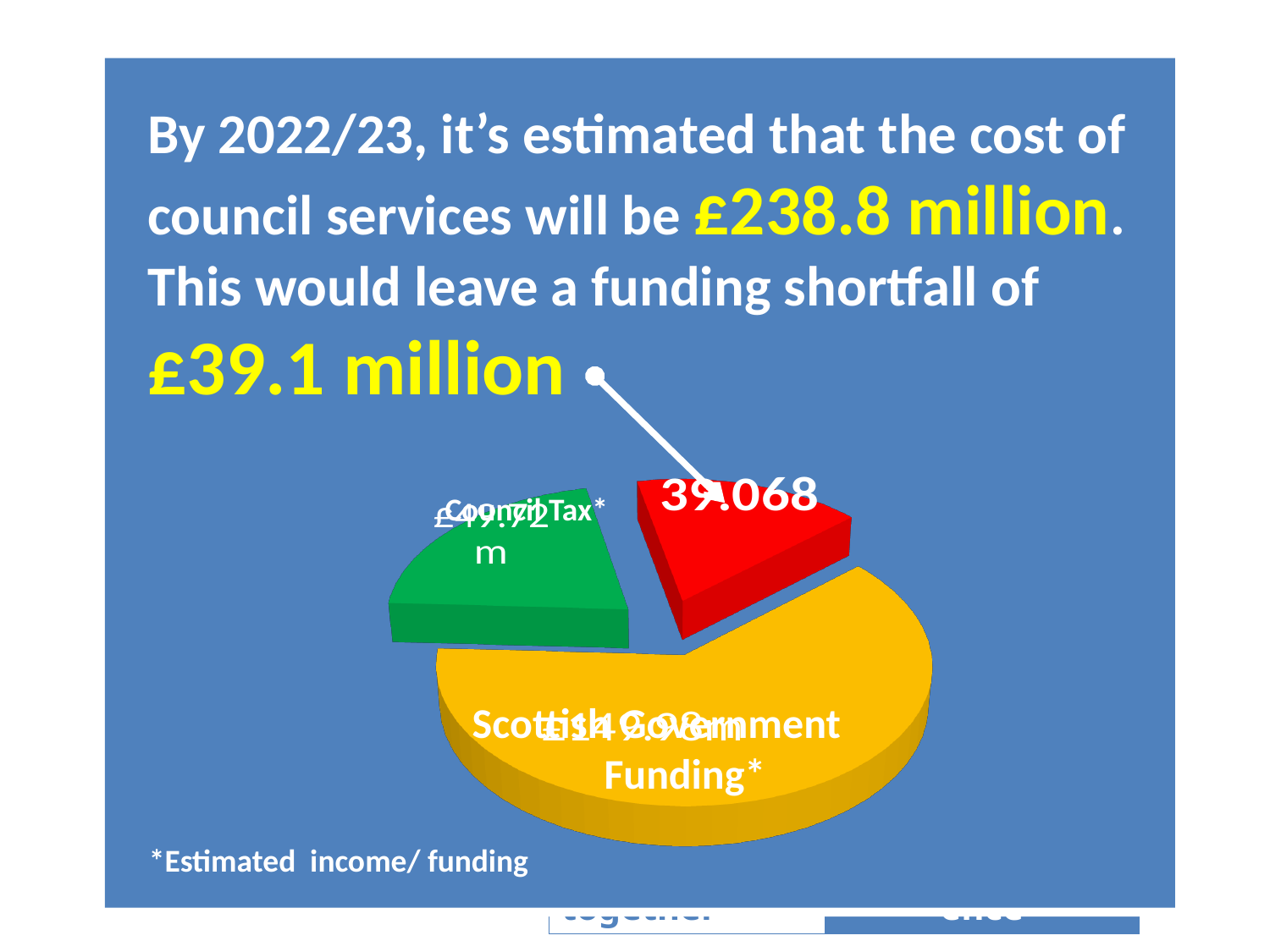
What value is printed on the red slice of the pie chart? 39.068 What colour is the Council Tax* slice of the pie chart? green Which slice of the pie chart is the largest? Scottish Government Funding* What kind of chart is shown on the slide? pie chart Which is larger in the pie chart: Scottish Government Funding* or Council Tax*? Scottish Government Funding* Which slice of the pie chart is pulled out from the rest of the pie? the red slice (39.068) Which slice of the pie chart is the smallest? the red slice (39.068) How many slices does the pie chart have? 3